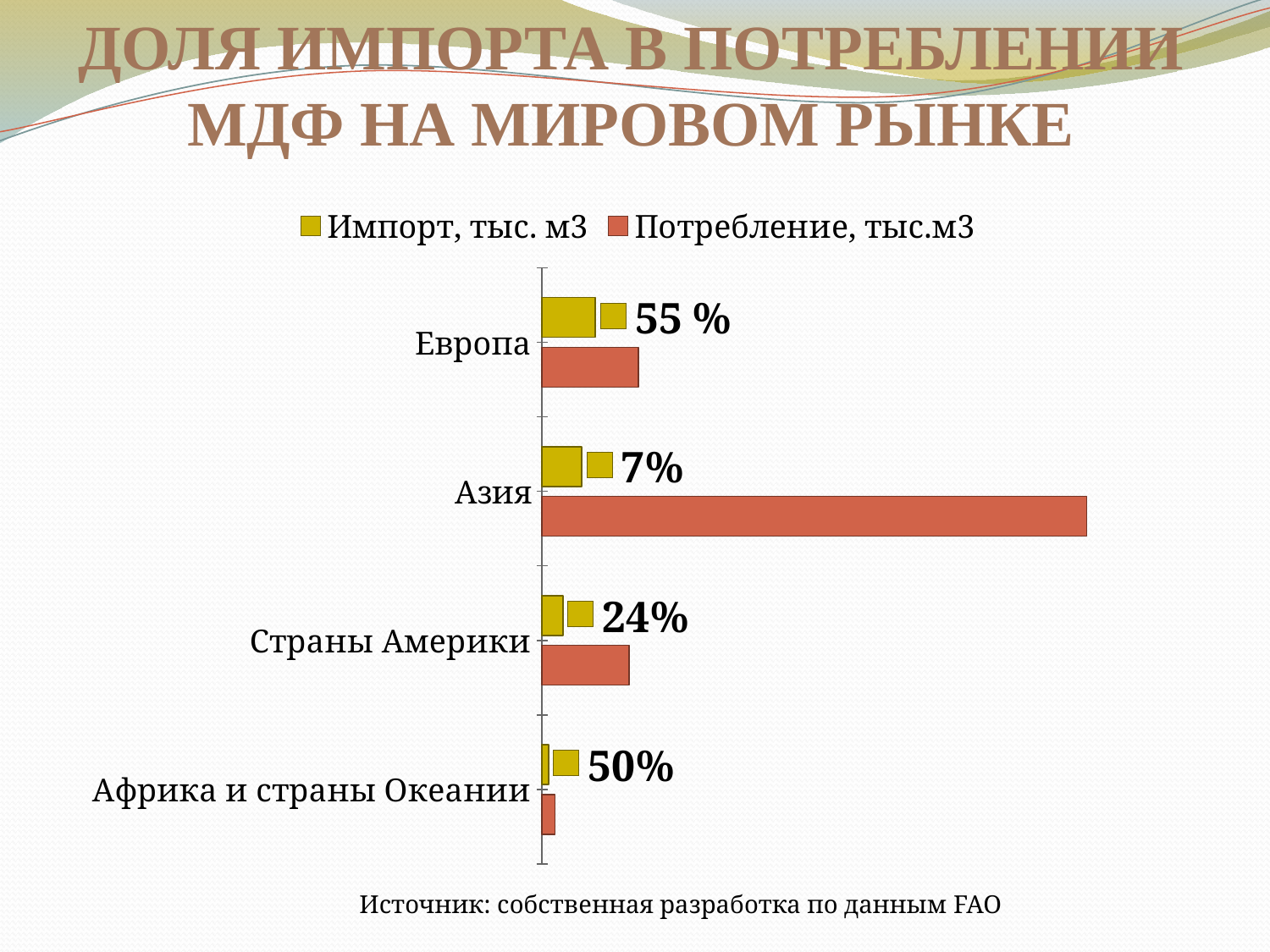
Which region has the highest value for Импорт, тыс. м3? Европа What percentage label is shown for Азия? 7% What percentage label is shown for Европа? 55 % Which region has the lowest value for Потребление, тыс.м3? Африка и страны Океании How many series does the legend list? 2 How many regions (categories) are shown on the chart? 4 Which region has the lower percentage label, Азия or Страны Америки? Азия What kind of chart is shown on the slide? bar chart What percentage label is shown for Африка и страны Океании? 50% Which region has the highest value for Потребление, тыс.м3? Азия What are the two series named in the legend? Импорт, тыс. м3 and Потребление, тыс.м3 What percentage label is shown for Страны Америки? 24%